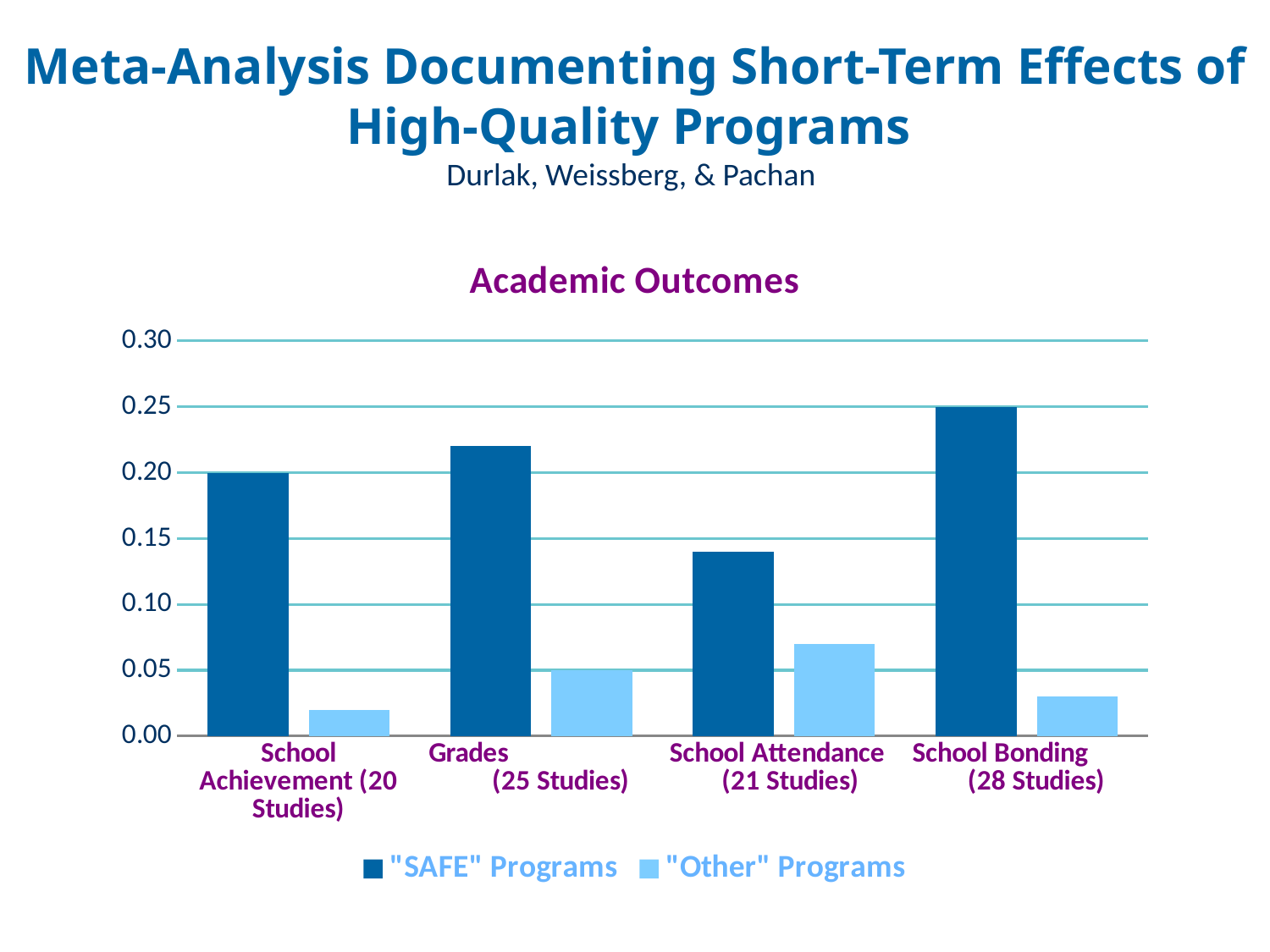
Which category has the highest value for "Other" Programs? School Attendance (21 Studies) Is the value for "SAFE" Programs for Grades (25 Studies) greater or less than 0.20? greater What is the value for "SAFE" Programs for School Achievement (20 Studies)? 0.20 What is the value for "SAFE" Programs for School Bonding (28 Studies)? 0.25 What type of chart is shown on the slide? bar chart What is the title of the chart? Academic Outcomes What is the value for "Other" Programs for Grades (25 Studies)? 0.05 Which category has the highest value for "SAFE" Programs? School Bonding (28 Studies) How many series does the legend list? 2 How many outcome categories are shown on the x axis? 4 Which category has the lowest value for "SAFE" Programs? School Attendance (21 Studies) Is the value for "SAFE" Programs for School Attendance (21 Studies) greater or less than 0.15? less